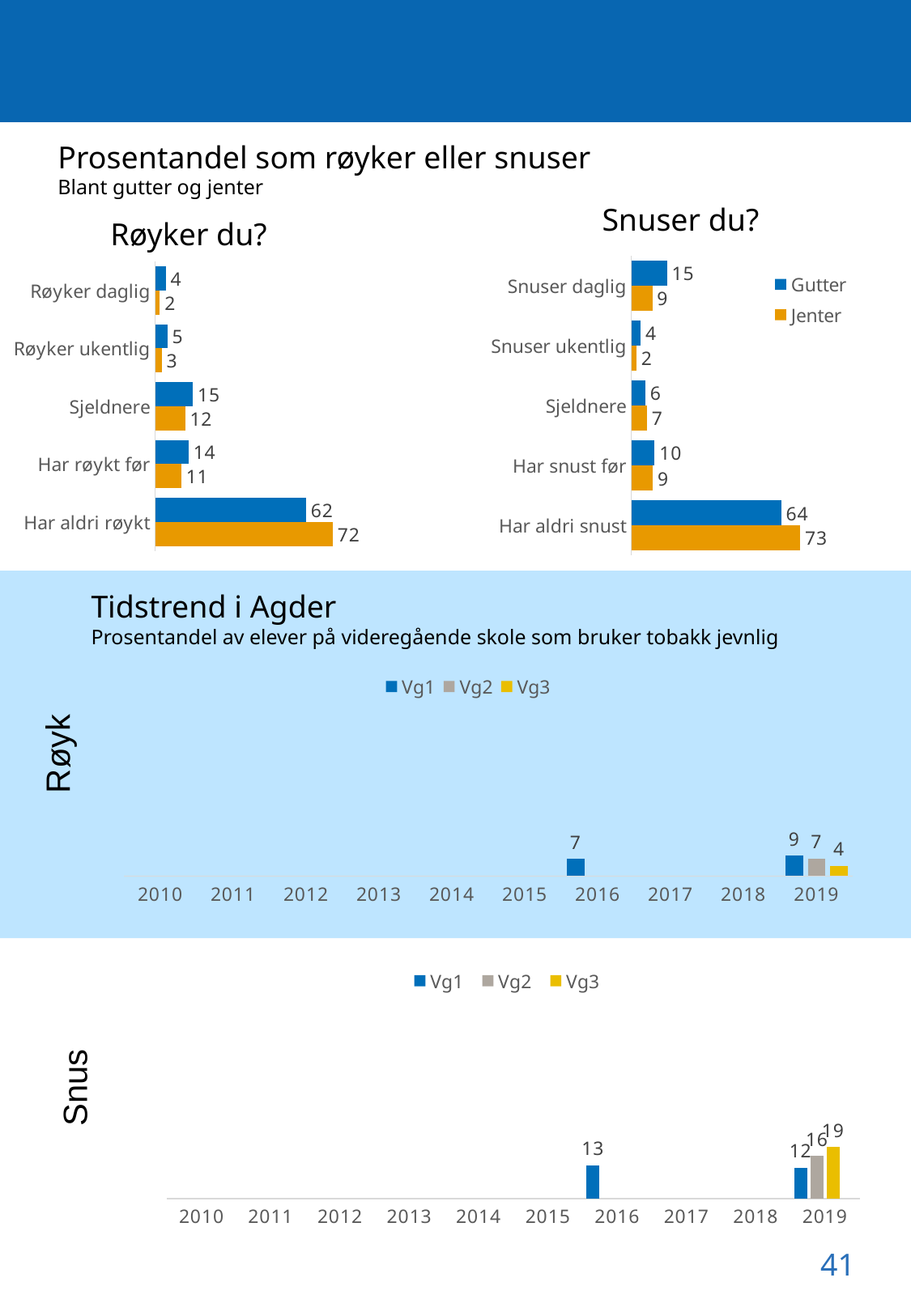
In the 'Røyker du?' chart, what is the value for Gutter in the 'Har aldri røykt' category? 62 In the 'Snuser du?' chart, which category has the highest value for Jenter? Har aldri snust How many categories does the 'Røyker du?' chart show? 5 In the 'Røyk' time trend chart, what is the value for Vg3 in 2019? 4 How many series does the legend of the 'Røyk' time trend chart list? 3 In the 'Snuser du?' chart, what is the value for Gutter in the 'Snuser daglig' category? 15 In the 'Snus' time trend chart, what is the value for Vg1 in 2016? 13 In the 'Røyker du?' chart, what is the value for Jenter in the 'Sjeldnere' category? 12 What type of chart is the 'Snuser du?' chart? Bar chart In the 'Snuser du?' chart, which is larger in the 'Snuser daglig' category, Gutter or Jenter? Gutter In the 'Snuser du?' chart, what is the difference between Jenter and Gutter in the 'Har aldri snust' category? 9 In the 'Røyker du?' chart, which category has the lowest value for Jenter? Røyker daglig